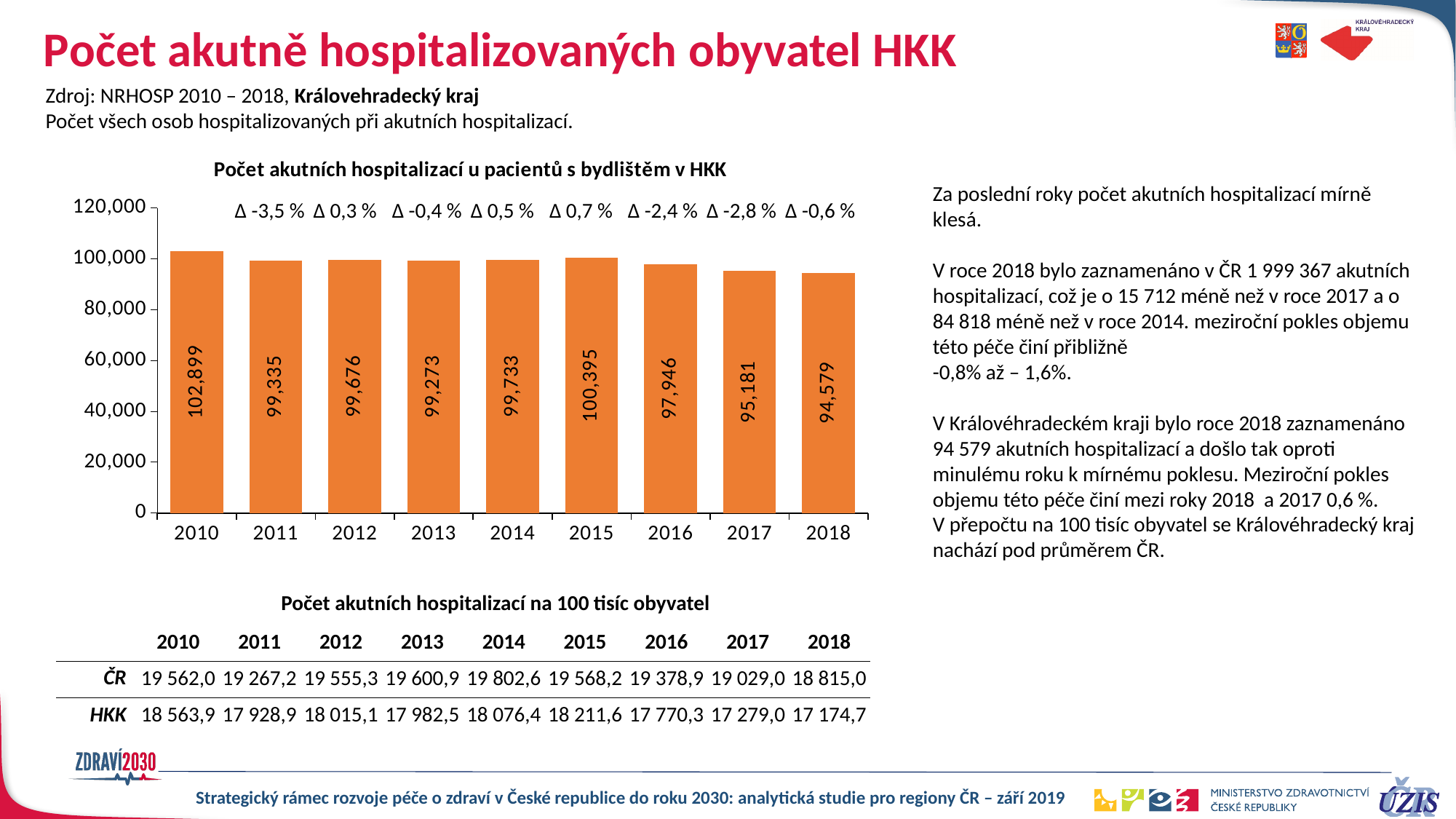
What kind of chart is shown on the slide? bar chart What is the value for 2010 in the chart? 102,899 What is the difference between the values for 2010 and 2018? 8,320 Which year has the lowest value in the chart? 2018 What is the value for 2018 in the chart? 94,579 What is the value for 2015 in the chart? 100,395 Is the value for 2018 greater or less than 100,000? less What percentage change (Δ) is printed above the bar for 2011? Δ -3,5 % What is the difference between the values for 2017 and 2018? 602 Which year has the highest value in the chart? 2010 How many years are shown on the x axis of the chart? 9 Which is larger, the value for 2015 or the value for 2016? 2015